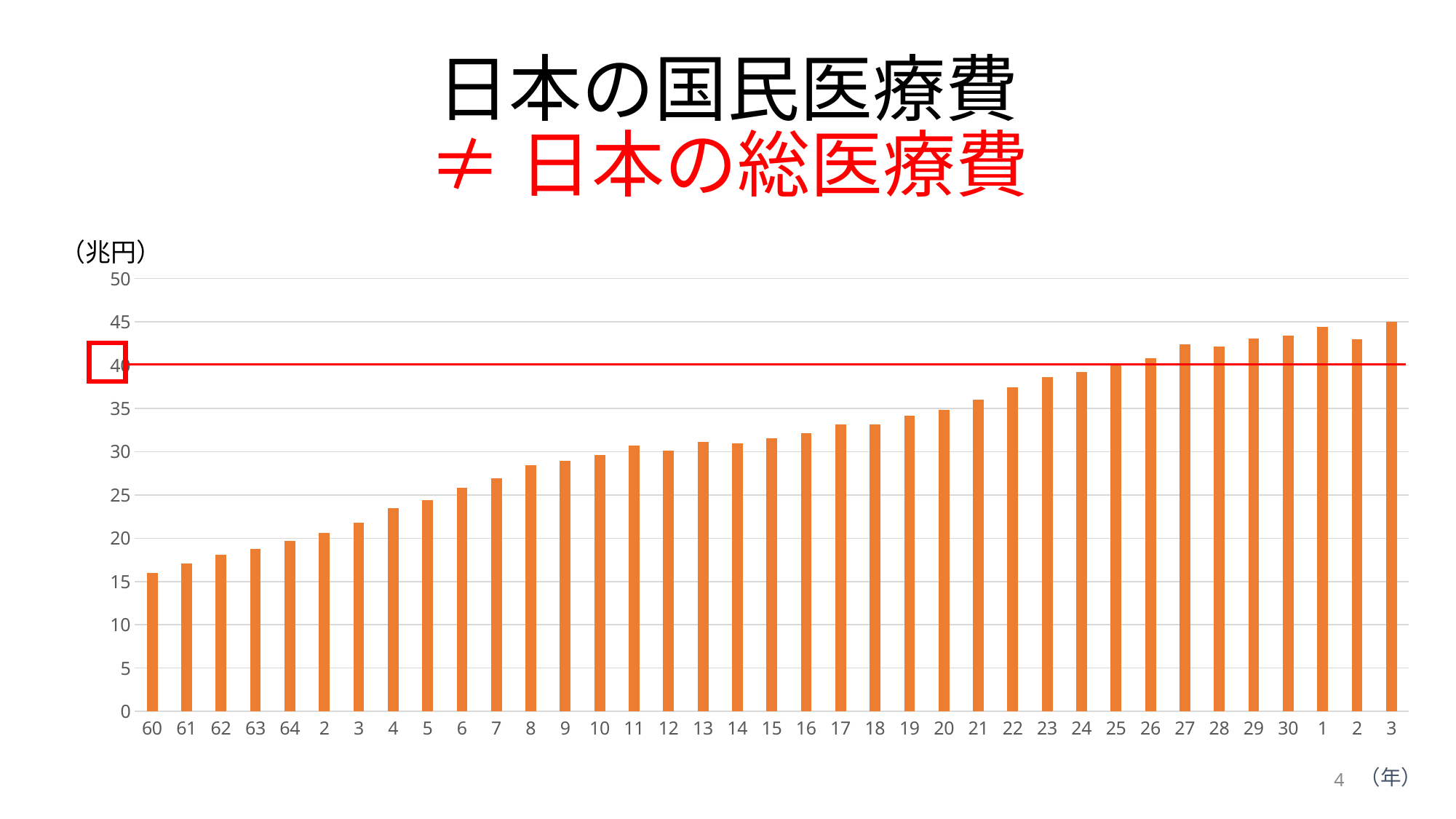
Which is larger, the value for year 24 or the value for year 26? 26 How many bars (years) are plotted in the chart? 37 Is the value for year 21 greater or less than 35? greater At which y-axis value is the horizontal red line drawn across the chart? 40 Do the values generally rise or fall from left to right along the x axis? rise Is the value for year 60 greater or less than 20? less Which year has the highest bar in the chart? 3 (the rightmost bar) What kind of chart is shown on the slide? bar chart Is the value for year 27 greater or less than 40? greater Which year has the lowest bar in the chart? 60 (the leftmost bar) What unit is shown for the y axis of the chart? 兆円